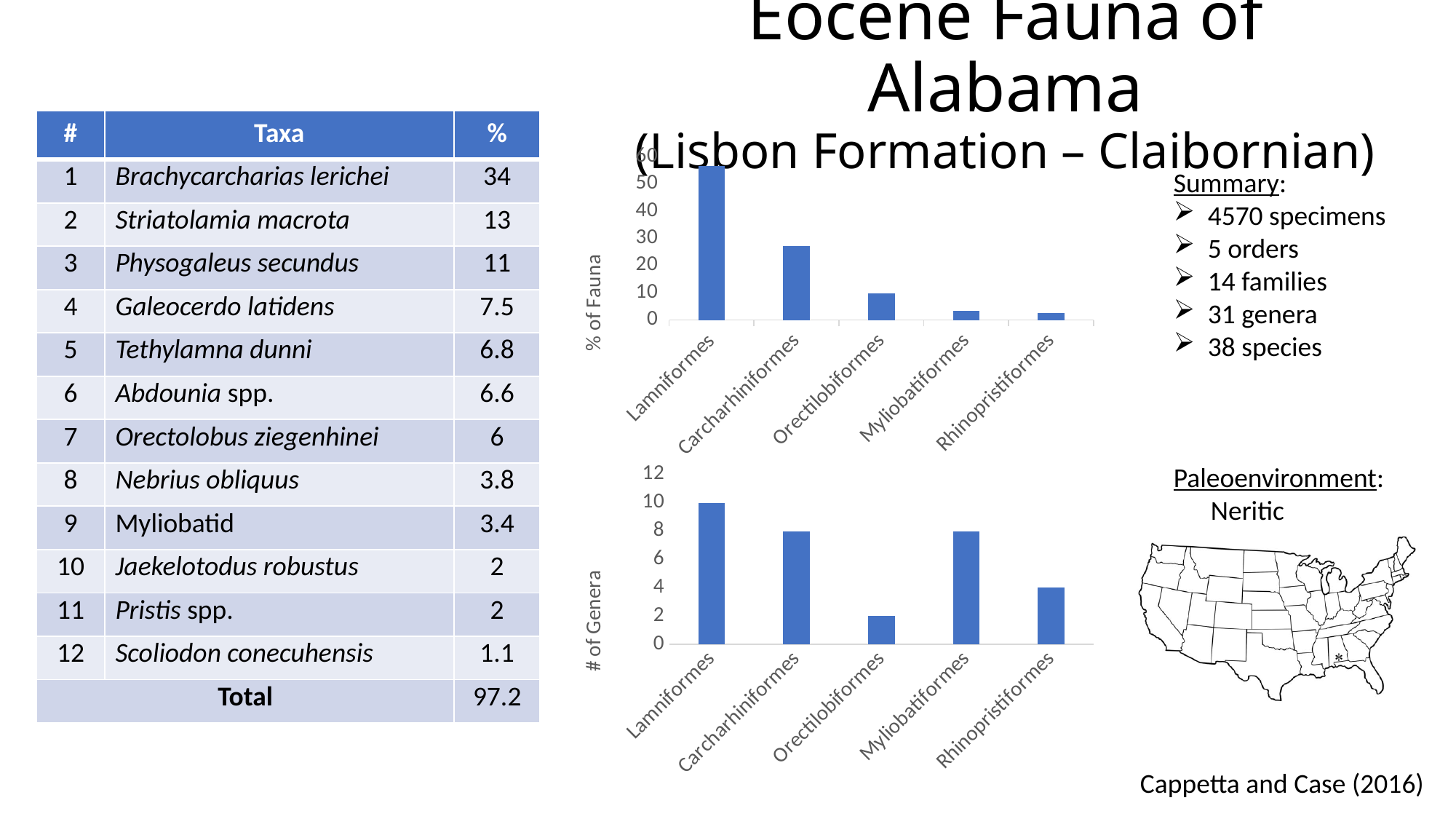
In the top chart (% of Fauna), is the value for Carcharhiniformes greater or less than 30? less In the bottom chart (# of Genera), what is the value for Orectilobiformes? 2 In the top chart (% of Fauna), is the value for Lamniformes greater or less than 50? greater What kind of chart is the top chart (% of Fauna)? bar chart In the bottom chart (# of Genera), what is the value for Lamniformes? 10 In the bottom chart (# of Genera), what is the difference between the values for Lamniformes and Rhinopristiformes? 6 In the bottom chart (# of Genera), which order has the lowest value? Orectilobiformes In the top chart (% of Fauna), which is larger, the value for Carcharhiniformes or the value for Orectilobiformes? Carcharhiniformes What is the y-axis title of the bottom chart? # of Genera In the top chart (% of Fauna), which order has the highest value? Lamniformes How many categories are shown on the x axis of the top chart (% of Fauna)? 5